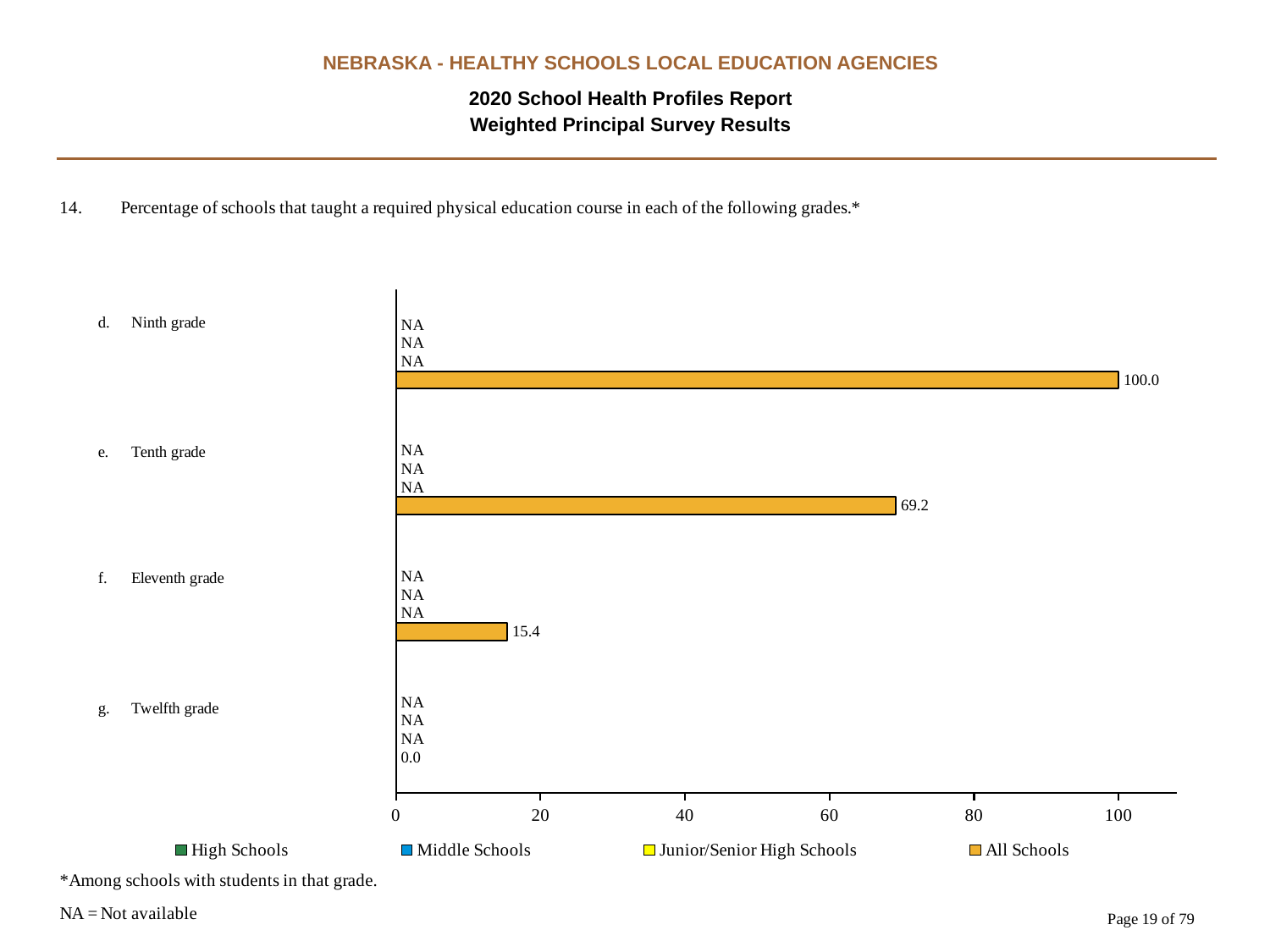
What kind of chart is shown on the slide? Bar chart What is the difference between the All Schools values for Ninth grade and Tenth grade? 30.8 How many series does the legend list? 4 Which is larger, the All Schools value for Tenth grade or for Eleventh grade? Tenth grade Which grade has the highest All Schools value? Ninth grade What value is shown for High Schools in Ninth grade? NA What is the All Schools value for Eleventh grade? 15.4 Which grade has the lowest All Schools value? Twelfth grade What is the All Schools value for Twelfth grade? 0.0 What is the All Schools value for Tenth grade? 69.2 How many grade categories are shown on the chart? 4 What is the All Schools value for Ninth grade? 100.0